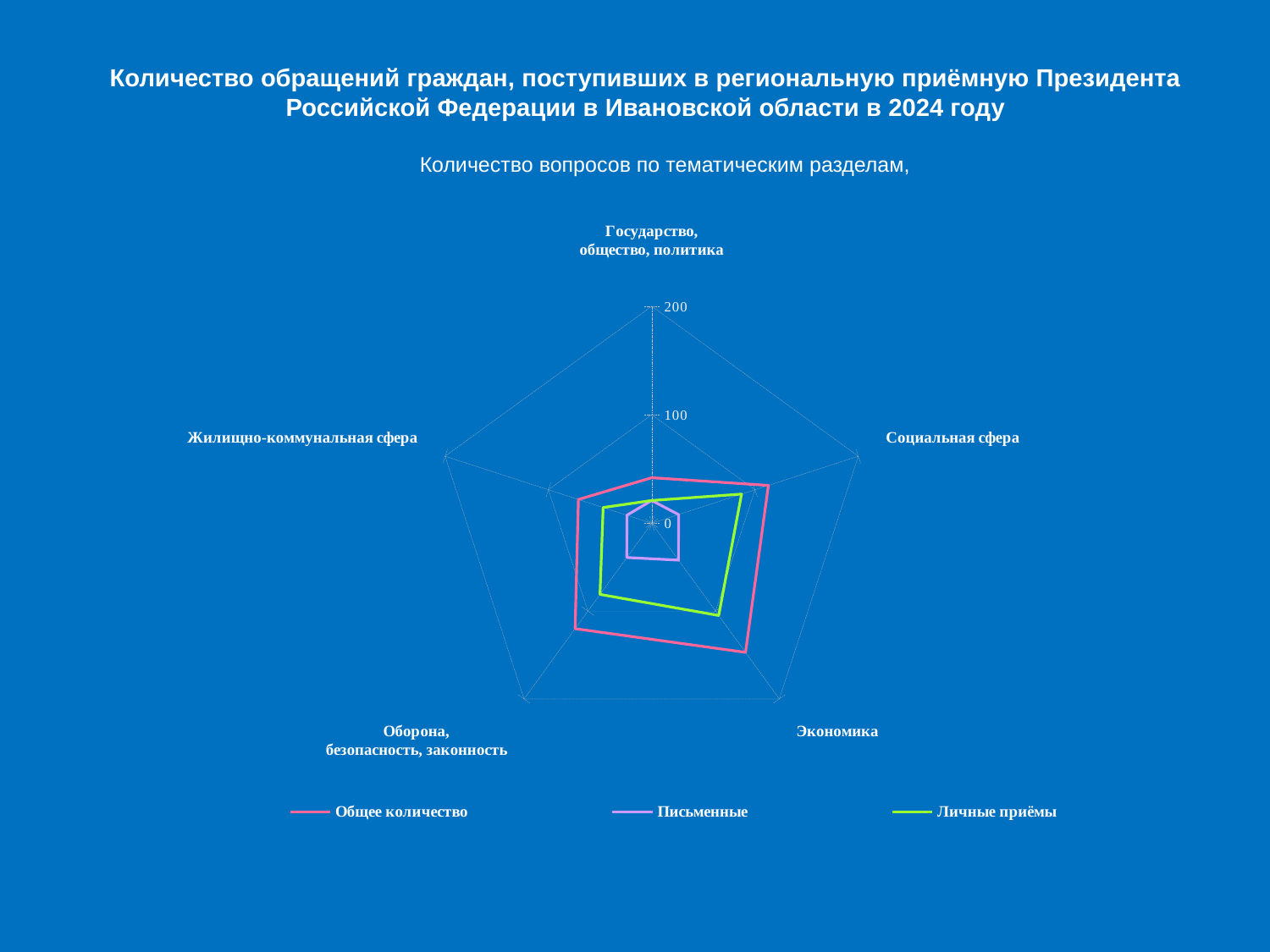
What is the maximum value shown on the chart's radial axis? 200 For the series "Общее количество", which category has the larger value: "Экономика" or "Государство, общество, политика"? Экономика How many series does the legend list? 3 Which category has the lowest value for the series "Общее количество"? Государство, общество, политика For "Экономика", which series has the larger value: "Личные приёмы" or "Письменные"? Личные приёмы How many thematic categories (axes) does the radar chart have? 5 Is the value of "Общее количество" for "Экономика" greater or less than 100? greater Is the value of "Письменные" for "Социальная сфера" greater or less than 100? less Is the value of "Общее количество" for "Государство, общество, политика" greater or less than 100? less Which colour represents the series "Личные приёмы" in the legend? Green What kind of chart is shown on the slide? Radar chart Which category has the highest value for the series "Общее количество"? Экономика